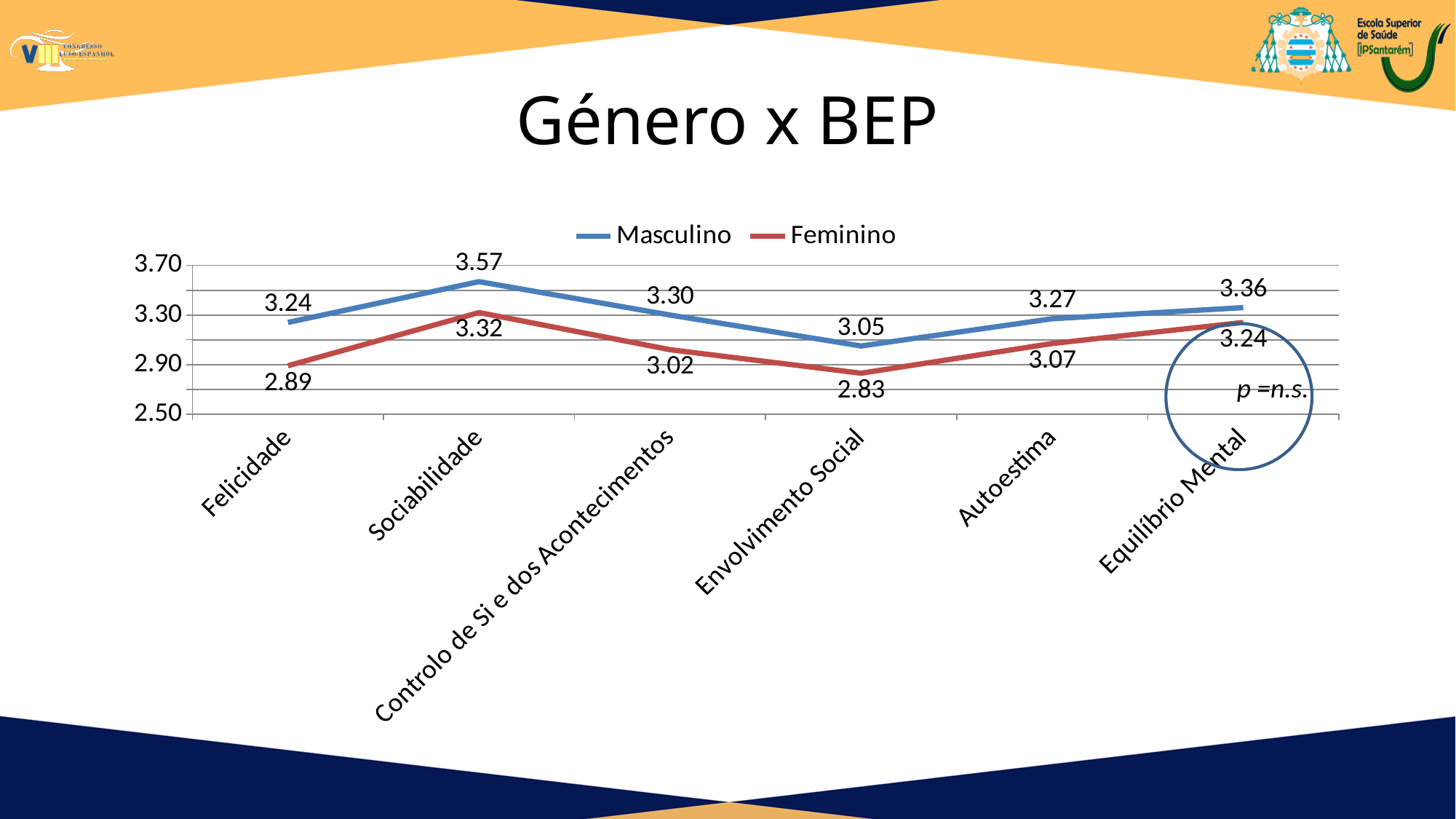
What is the Masculino value for Equilíbrio Mental? 3.36 Which is larger for Autoestima, the Masculino value or the Feminino value? Masculino What is the title of the slide containing the chart? Género x BEP What is the difference between the Masculino and Feminino values for Felicidade? 0.35 What is the Masculino value for Sociabilidade? 3.57 How many series does the legend list? 2 What type of chart is shown on the slide? line chart Which category has the highest Masculino value? Sociabilidade What is the Feminino value for Felicidade? 2.89 How many categories are shown on the x axis? 6 What is the Feminino value for Envolvimento Social? 2.83 Which category has the lowest Feminino value? Envolvimento Social